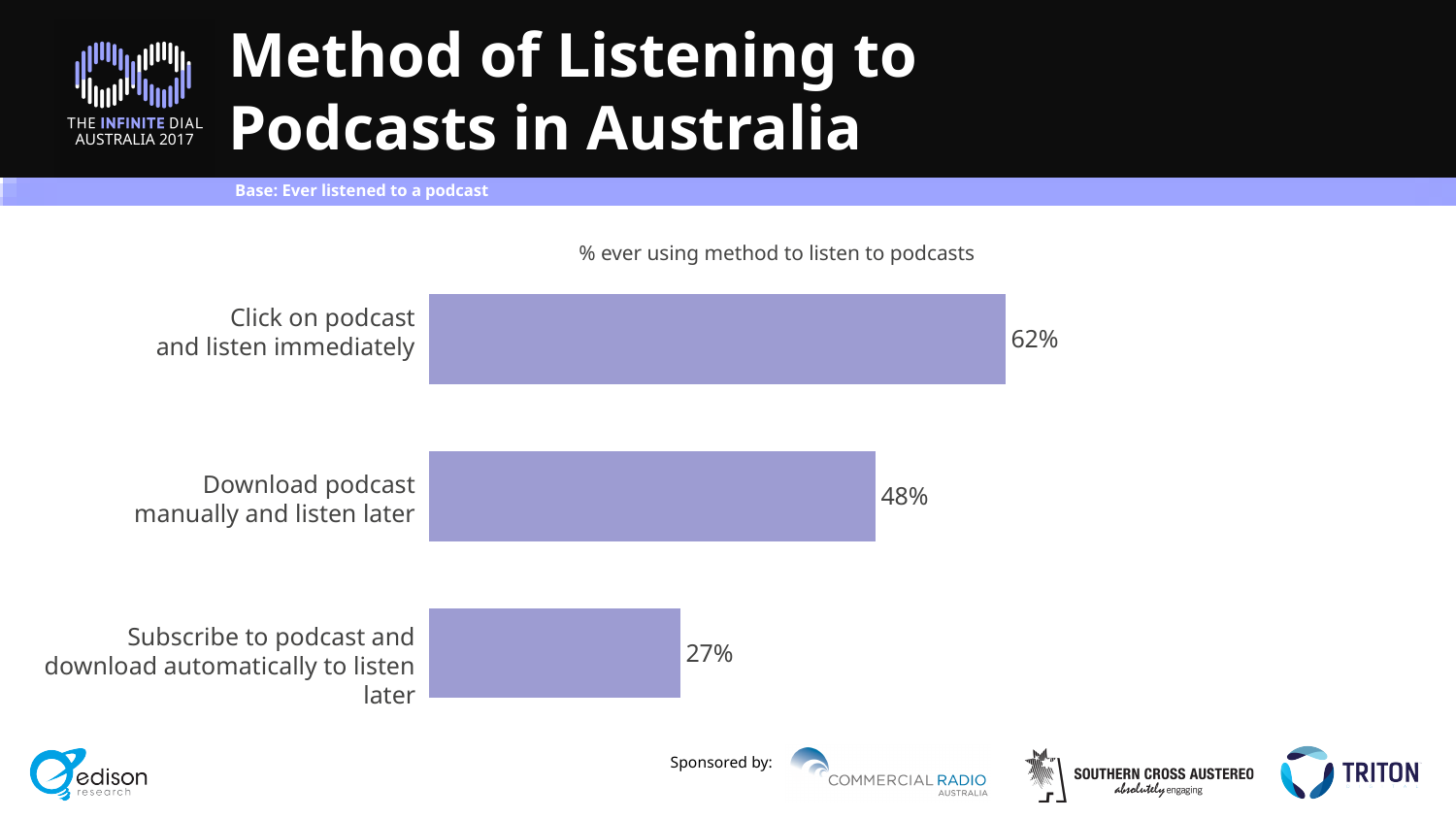
How many listening methods are shown in the chart? 3 What percentage of podcast listeners click on a podcast and listen immediately? 62% Which is larger: the percentage who download manually and listen later, or the percentage who subscribe and download automatically? Download podcast manually and listen later What is the base population stated for the chart? Ever listened to a podcast What percentage of podcast listeners download a podcast manually and listen later? 48% What is the difference in percentage points between clicking on a podcast and listening immediately and downloading manually to listen later? 14 Which method of listening to podcasts has the lowest percentage? Subscribe to podcast and download automatically to listen later What is the difference in percentage points between downloading a podcast manually and subscribing to download automatically? 21 What type of chart is used on this slide? Bar chart What is the subtitle shown above the bars in the chart? % ever using method to listen to podcasts Which method of listening to podcasts has the highest percentage? Click on podcast and listen immediately What percentage of podcast listeners subscribe to a podcast and download automatically to listen later? 27%